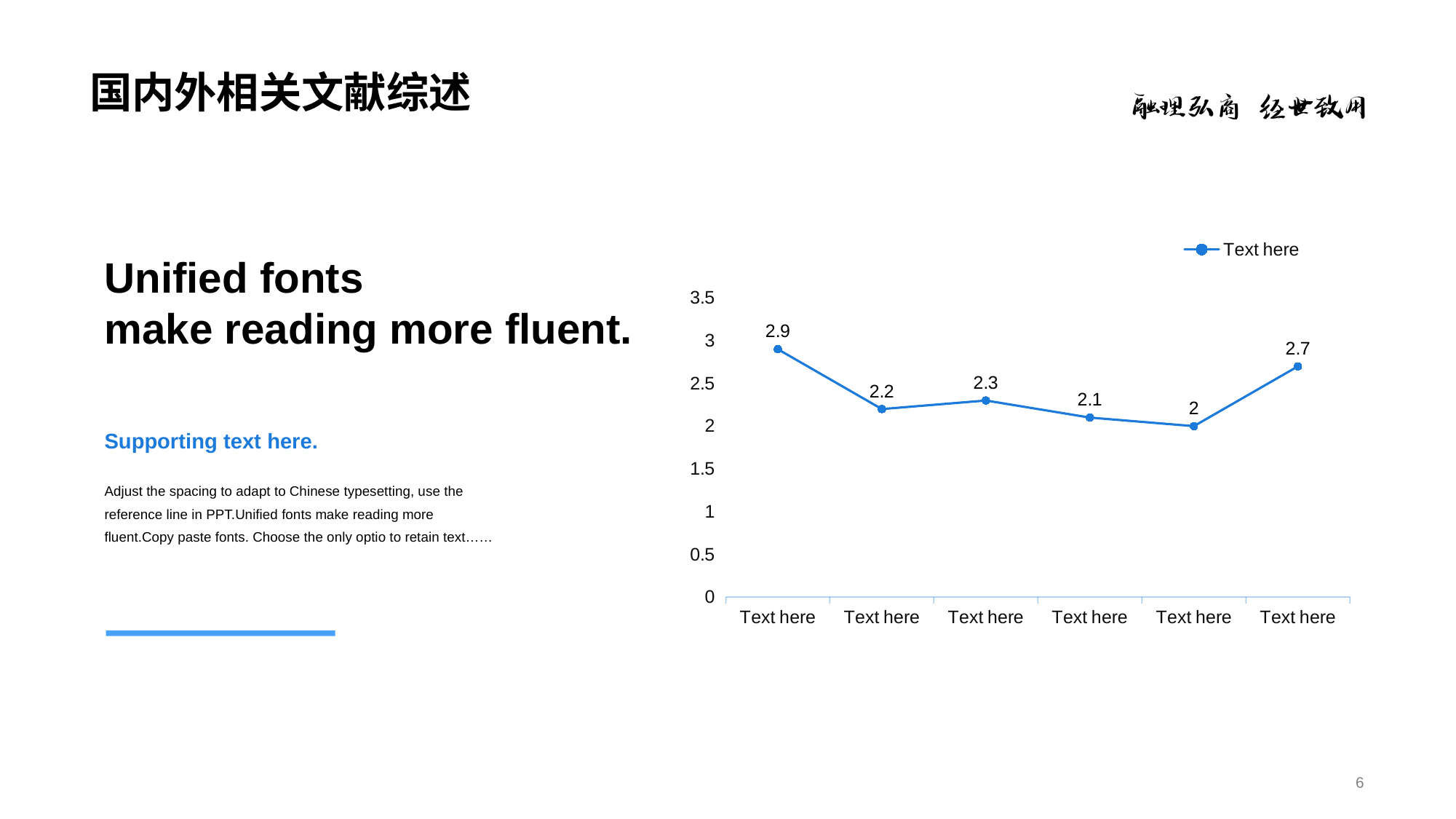
What is the name of the series shown in the legend of the line chart? Text here Which point on the line chart has the highest value? the first (leftmost) point, 2.9 What is the difference between the first point (2.9) and the fifth point (2) on the line chart? 0.9 Which is larger on the line chart: the second point or the third point? the third point (2.3) How many series does the legend of the line chart list? 1 What is the value of the third point from the left on the line chart? 2.3 How many data points are plotted on the line chart? 6 What is the value of the fifth point from the left on the line chart? 2 What is the value of the first (leftmost) point on the line chart? 2.9 Which point on the line chart has the lowest value? the fifth point, 2 What is the value of the last (rightmost) point on the line chart? 2.7 What kind of chart is shown on the slide? line chart